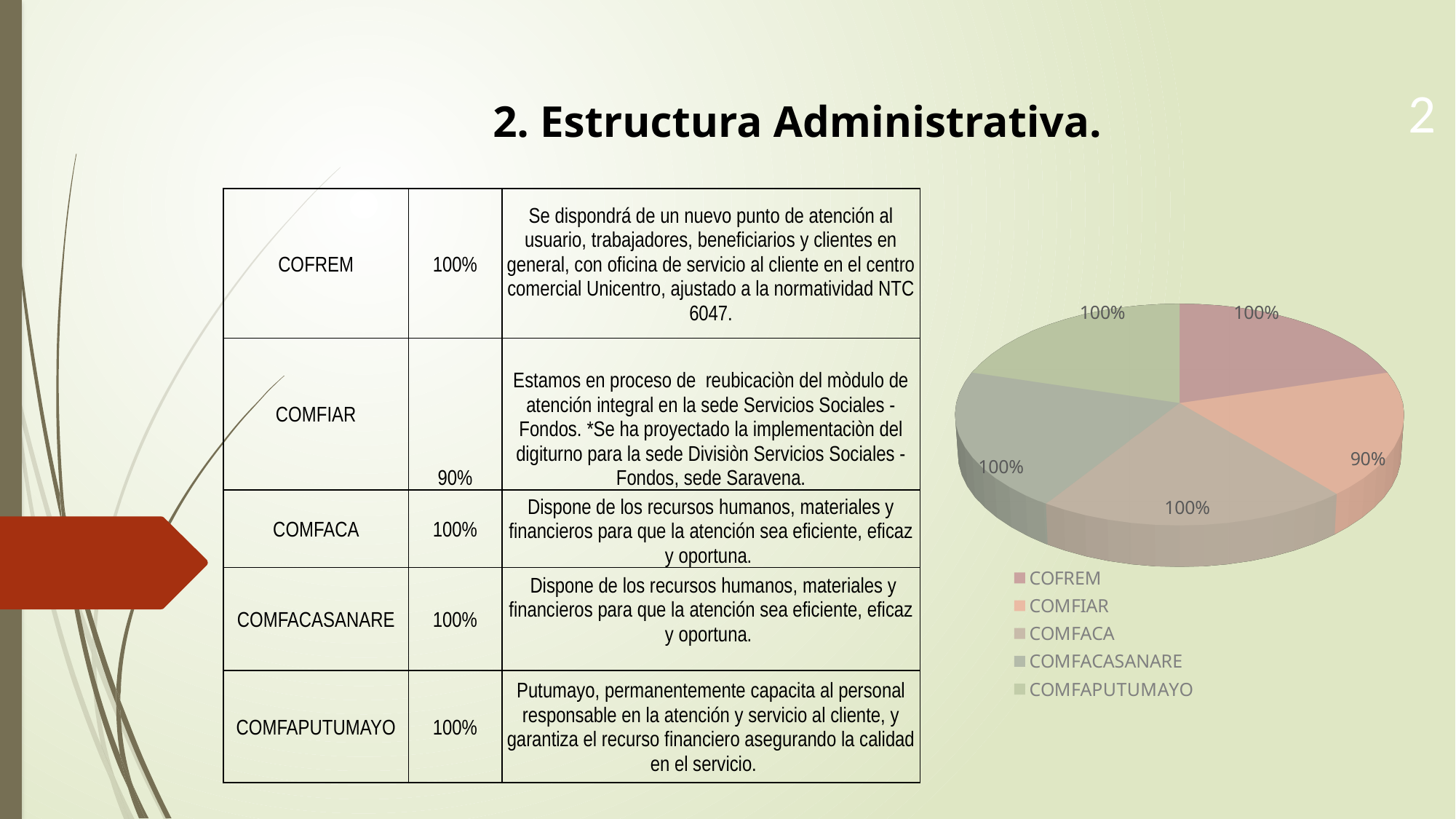
What value is shown for COFREM in the pie chart? 100% How many slices does the pie chart have? 5 What value is shown for COMFACASANARE in the pie chart? 100% Which category has the lowest value in the pie chart? COMFIAR Which legend entry is listed last in the pie chart's legend? COMFAPUTUMAYO What value is shown for COMFIAR in the pie chart? 90% What value is shown for COMFAPUTUMAYO in the pie chart? 100% What is the difference between the values for COFREM and COMFIAR in the pie chart? 10% Which legend entry is listed first in the pie chart's legend? COFREM How many entries does the legend of the pie chart list? 5 Which is larger in the pie chart, the value for COMFACA or the value for COMFIAR? COMFACA What kind of chart is shown on the slide? Pie chart